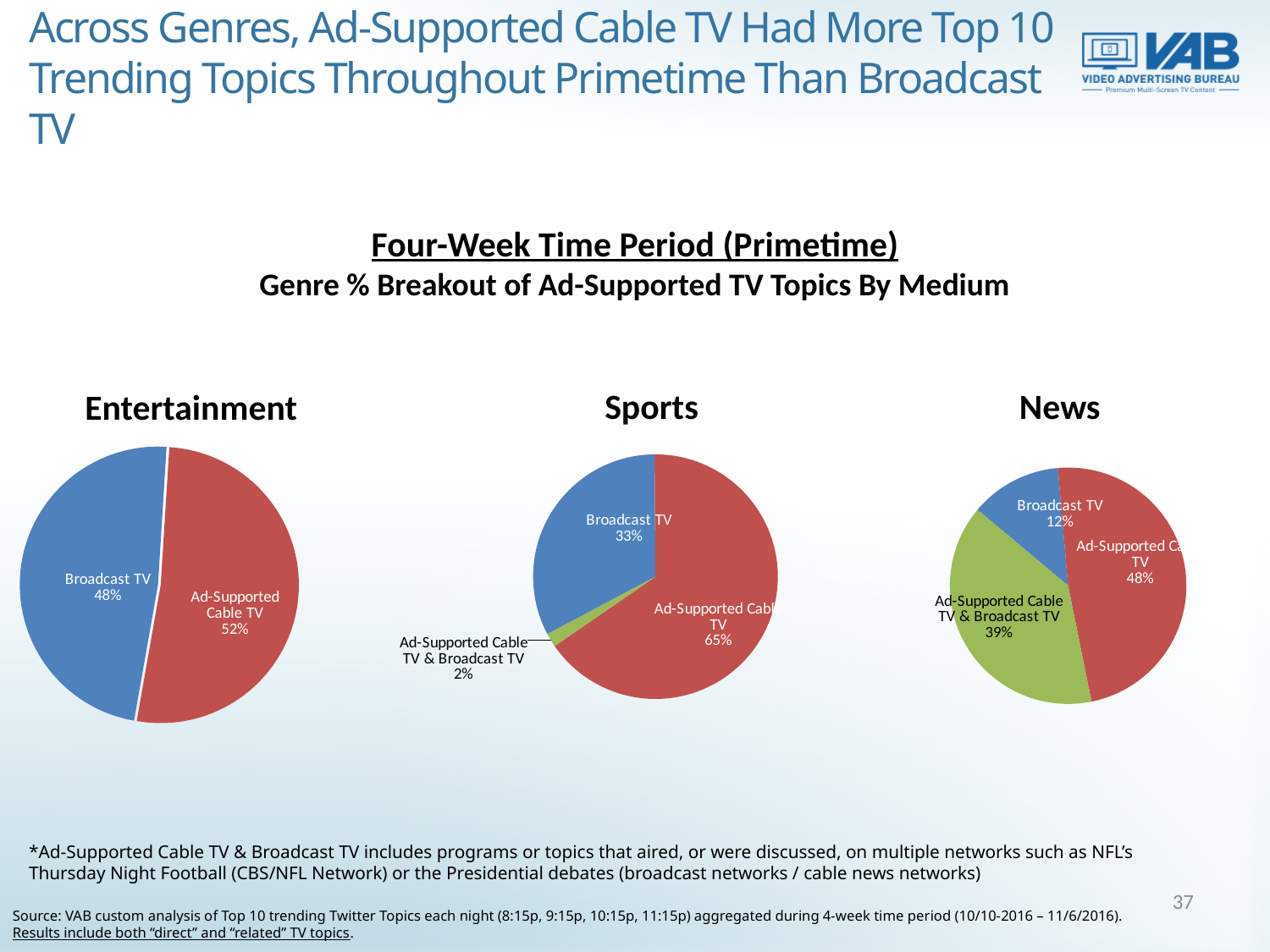
In the Sports pie chart, what share is Broadcast TV? 33% In the Sports pie chart, which slice is the largest? Ad-Supported Cable TV How many slices does the Entertainment pie chart have? 2 In the Entertainment pie chart, what share is Broadcast TV? 48% In the Sports pie chart, what share is Ad-Supported Cable TV & Broadcast TV? 2% What type of chart is used for the Sports genre? Pie chart In the Entertainment pie chart, what share is Ad-Supported Cable TV? 52% In the News pie chart, which is larger: Ad-Supported Cable TV or Broadcast TV? Ad-Supported Cable TV How many pie charts are shown on the slide? 3 In the Sports pie chart, what is the difference between the Ad-Supported Cable TV share and the Broadcast TV share? 32 percentage points In the News pie chart, what share is Ad-Supported Cable TV & Broadcast TV? 39% In the News pie chart, which slice is the smallest? Broadcast TV